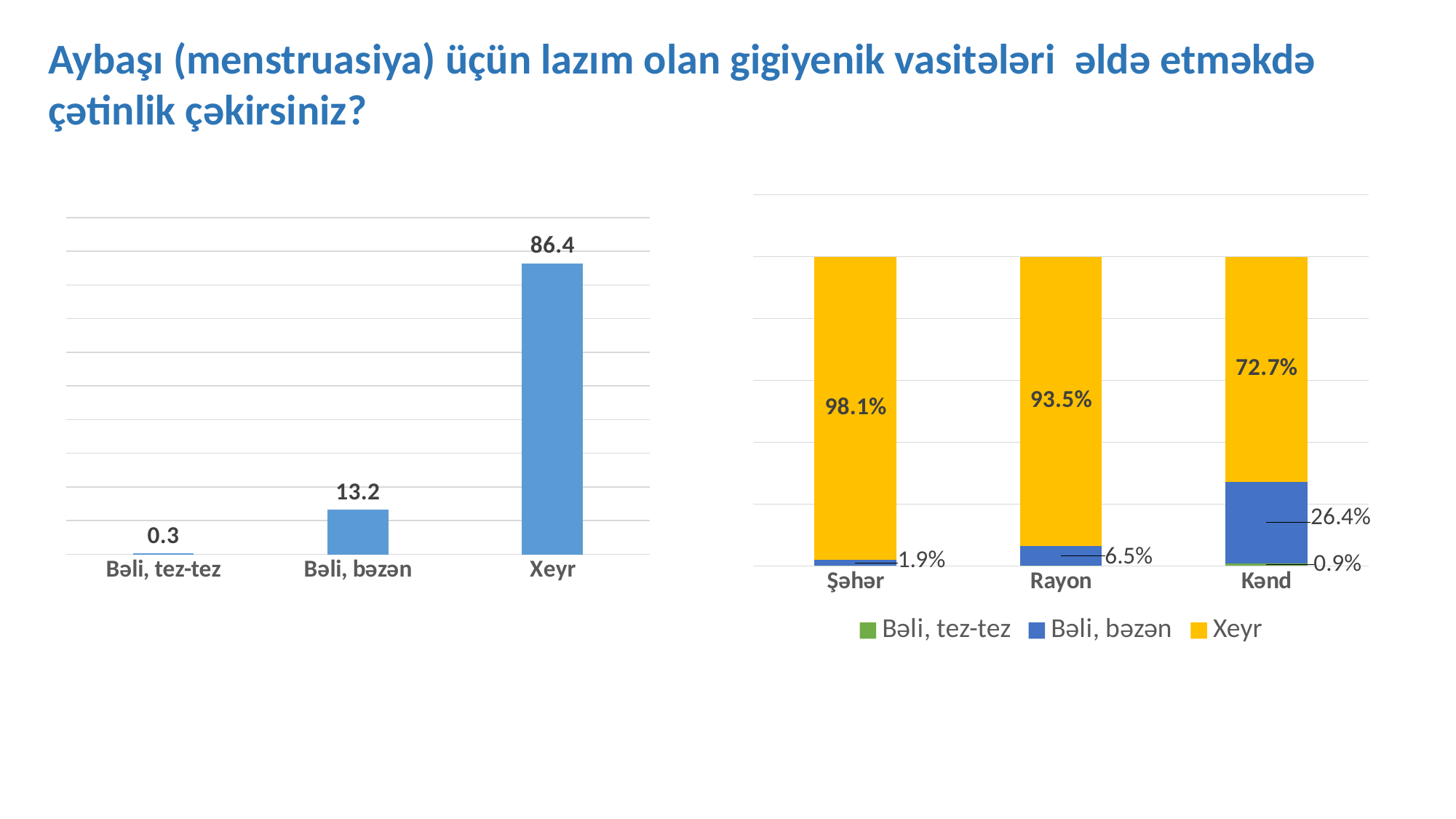
In the left chart, how many categories are shown? 3 In the right chart, which category has the highest Xeyr share? Şəhər In the right chart, what is the Bəli, bəzən share for Rayon? 6.5% In the left chart, what is the difference between the values for Xeyr and Bəli, bəzən? 73.2 In the right chart, which colour represents Xeyr? yellow In the left chart, what is the value for Xeyr? 86.4 In the right chart, what is the Xeyr share for Kənd? 72.7% In the right chart, which is larger: the Bəli, bəzən share for Kənd or for Şəhər? Kənd In the left chart, which category has the lowest value? Bəli, tez-tez In the right chart, how many series does the legend list? 3 In the left chart, what is the value for Bəli, bəzən? 13.2 What kind of chart is the left chart? bar chart